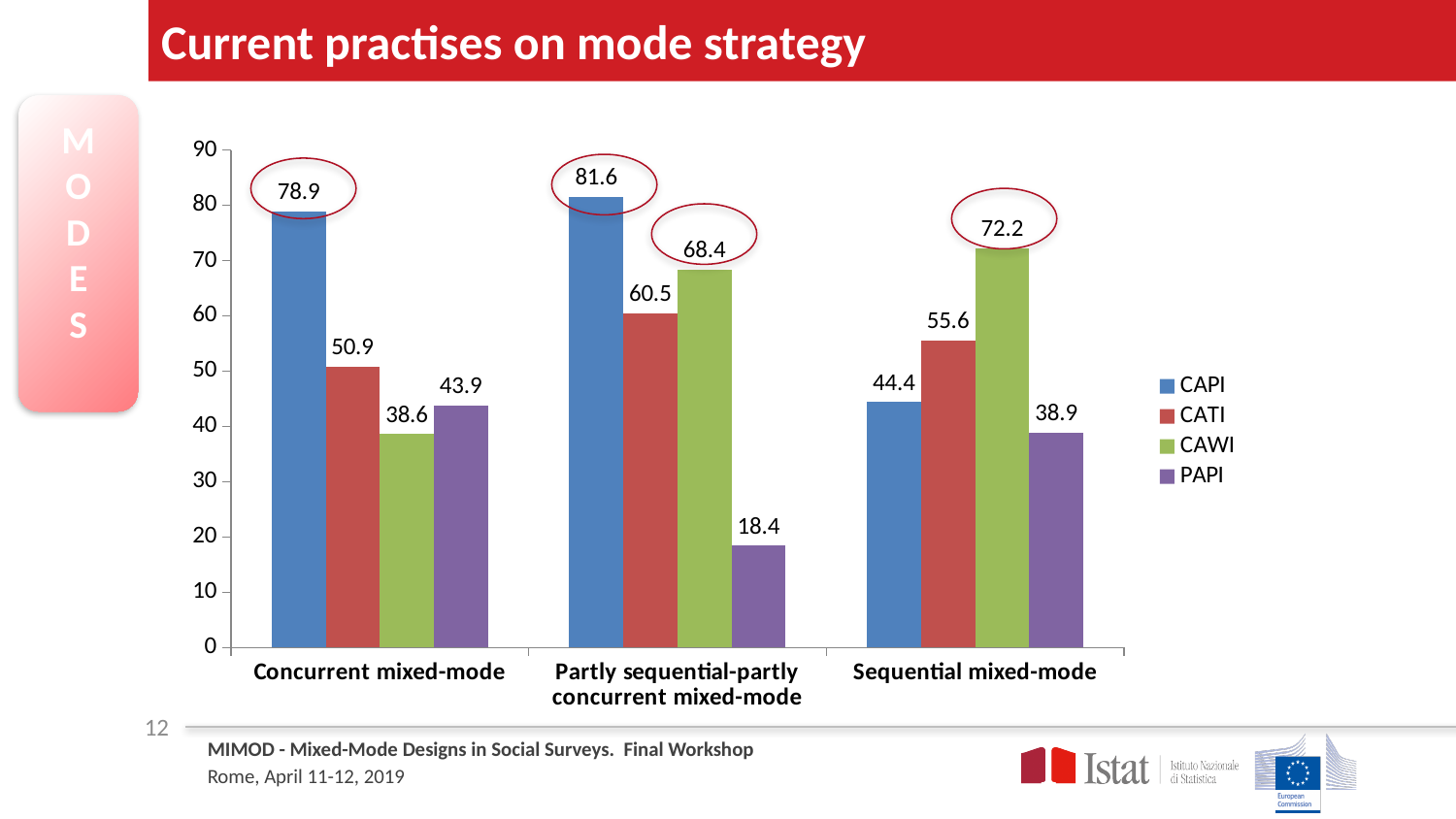
Is the CATI value for Partly sequential-partly concurrent mixed-mode greater or less than 50? greater Which mode has the lowest value for Partly sequential-partly concurrent mixed-mode? PAPI Which is larger for Sequential mixed-mode, CAPI or CATI? CATI What is the PAPI value for Sequential mixed-mode? 38.9 What is the CAWI value for Partly sequential-partly concurrent mixed-mode? 68.4 What kind of chart is shown on the slide? bar chart How many series does the legend list? 4 Which mode has the highest value for Sequential mixed-mode? CAWI What is the difference between the CAPI and CATI values for Concurrent mixed-mode? 28 Which series is shown in green in the legend? CAWI What is the CAPI value for Concurrent mixed-mode? 78.9 How many mode strategy categories are shown on the x axis? 3